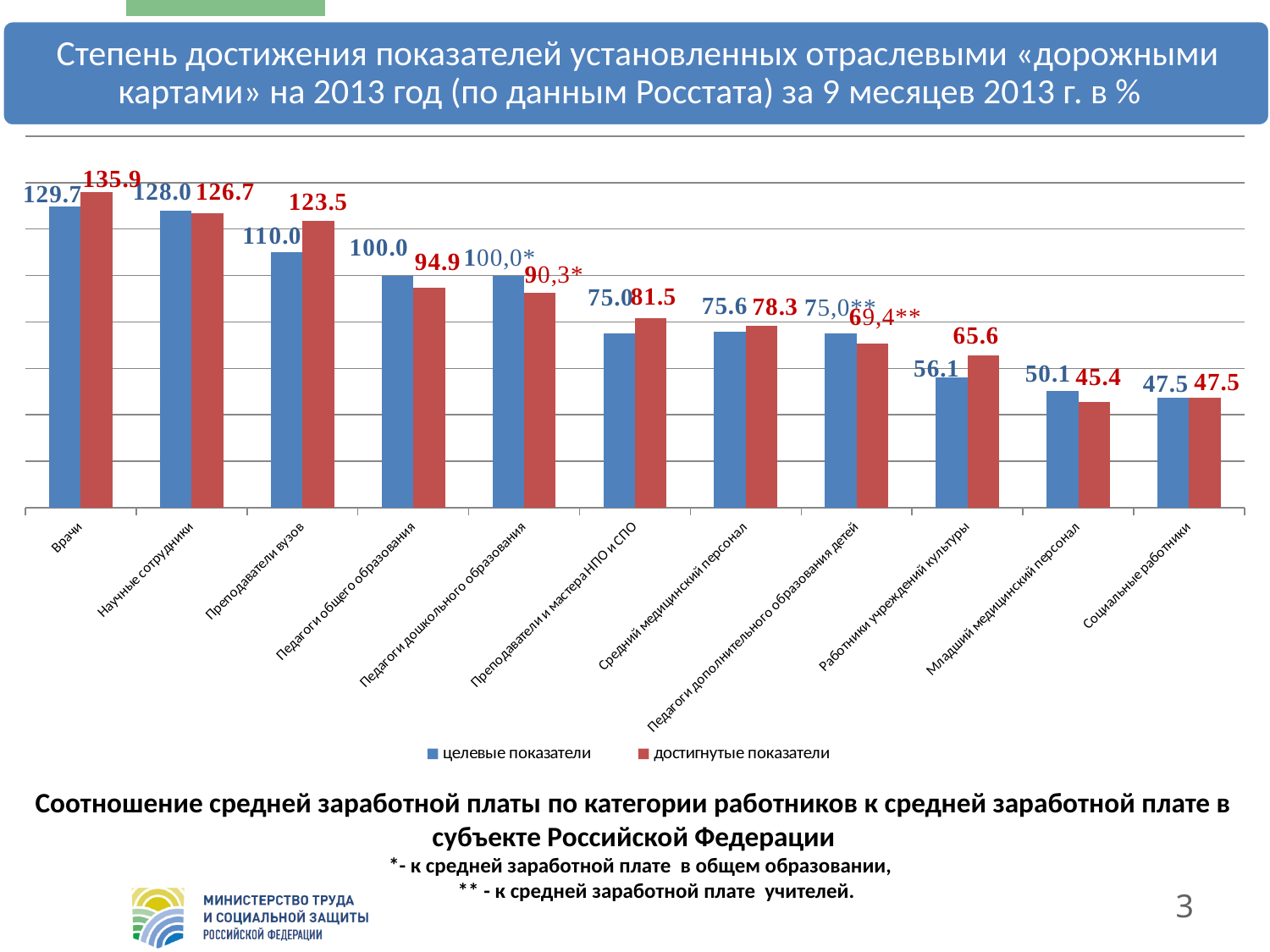
What is the value of «достигнутые показатели» for Работники учреждений культуры? 65.6 What kind of chart is shown on the slide? bar chart Which category has the lowest value of «целевые показатели»? Социальные работники Which colour represents «достигнутые показатели» in the chart? red What is the value of «достигнутые показатели» for Врачи? 135.9 Which category has the highest value of «достигнутые показатели»? Врачи How many series does the legend list? 2 What is the difference between «достигнутые показатели» and «целевые показатели» for Преподаватели вузов? 13.5 How many categories of workers are shown on the x axis? 11 What is the value of «целевые показатели» for Преподаватели вузов? 110.0 Do the values of «целевые показатели» generally rise or fall from left to right along the x axis? fall For Младший медицинский персонал, which is larger: «целевые показатели» or «достигнутые показатели»? целевые показатели